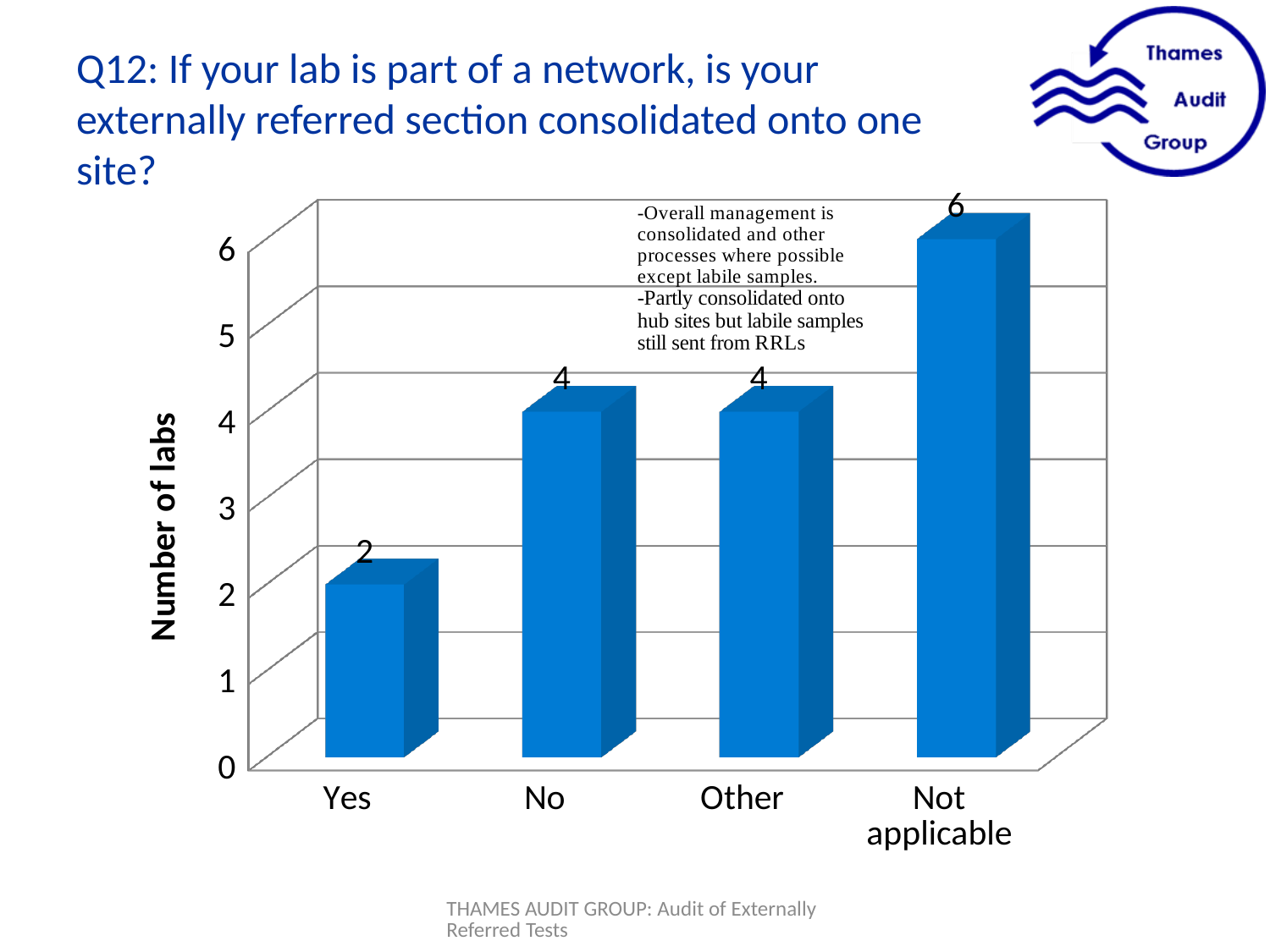
What is the value for "Not applicable"? 6 How many labs answered "No"? 4 Which is larger, the value for "No" or the value for "Yes"? No How many labs answered "Yes"? 2 Which category has the lowest number of labs? Yes Is the value for "Not applicable" greater or less than 5? greater What is the total number of labs across all four categories? 16 Which category has the highest number of labs? Not applicable How many categories are shown on the x axis? 4 What is the difference between the number of labs for "Not applicable" and "Yes"? 4 What kind of chart is shown on the slide? bar chart What is the label of the vertical axis? Number of labs